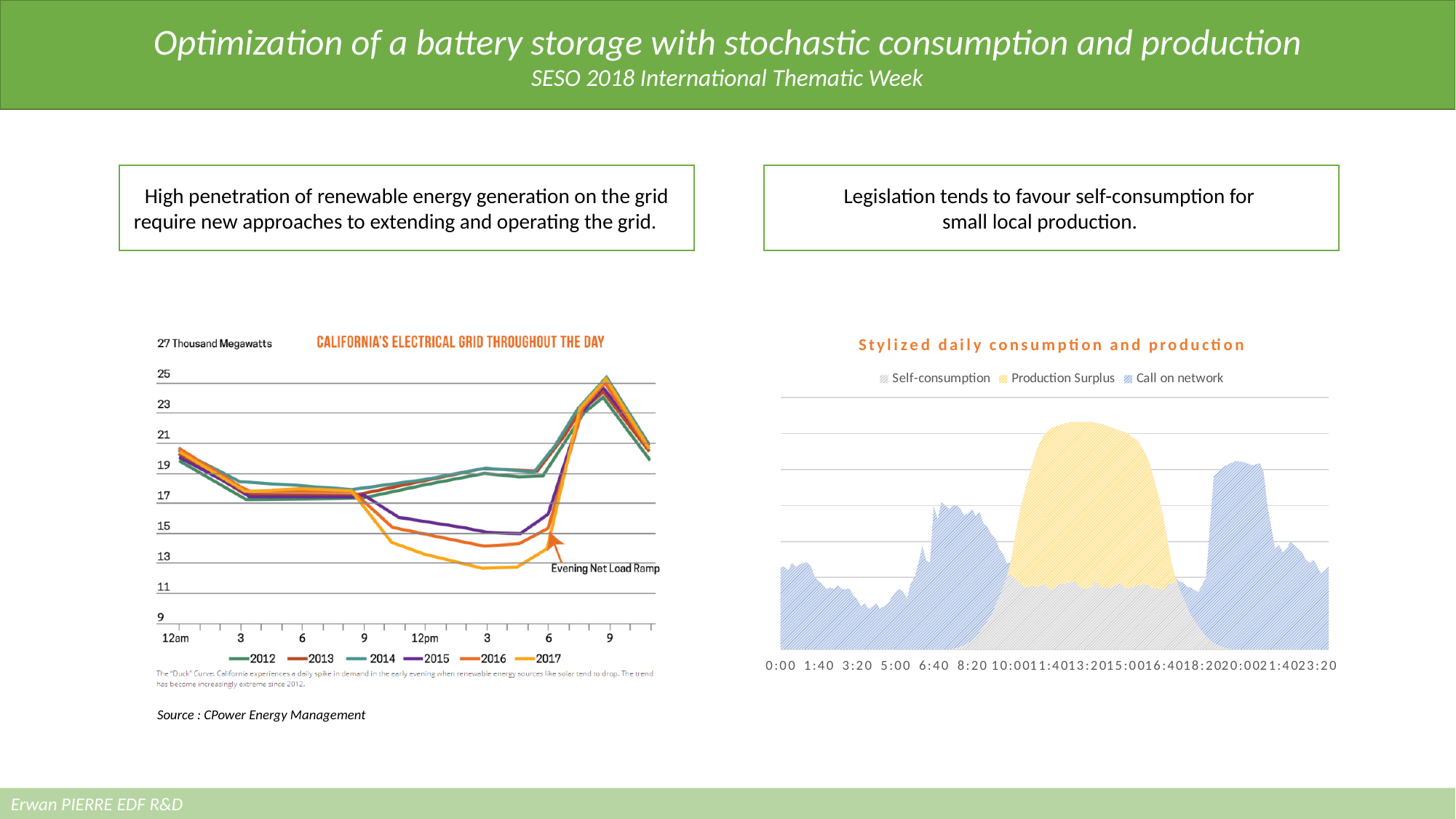
In the left chart, 'California's Electrical Grid Throughout the Day', do the lines rise or fall between 6pm and 9pm? rise In the right chart, 'Stylized daily consumption and production', which series is largest around 13:20? Production Surplus What kind of chart is the left chart, 'California's Electrical Grid Throughout the Day'? Line chart In the left chart, 'California's Electrical Grid Throughout the Day', is the 2017 value at 3pm larger or smaller than the 2012 value at 3pm? smaller What unit is shown on the y axis of the left chart, 'California's Electrical Grid Throughout the Day'? Thousand Megawatts What are the legend entries of the right chart, 'Stylized daily consumption and production'? Self-consumption, Production Surplus, Call on network How many series does the legend of the left chart, 'California's Electrical Grid Throughout the Day', list? 6 In the left chart, 'California's Electrical Grid Throughout the Day', do the lines rise or fall between 12am and 3am? fall In the left chart, 'California's Electrical Grid Throughout the Day', is the value for 2012 at 3pm greater or less than 17? greater In the left chart, 'California's Electrical Grid Throughout the Day', which year has the lowest value at 3pm? 2017 How many series does the legend of the right chart, 'Stylized daily consumption and production', list? 3 In the left chart, 'California's Electrical Grid Throughout the Day', is the value for 2017 at 3pm greater or less than 15? less